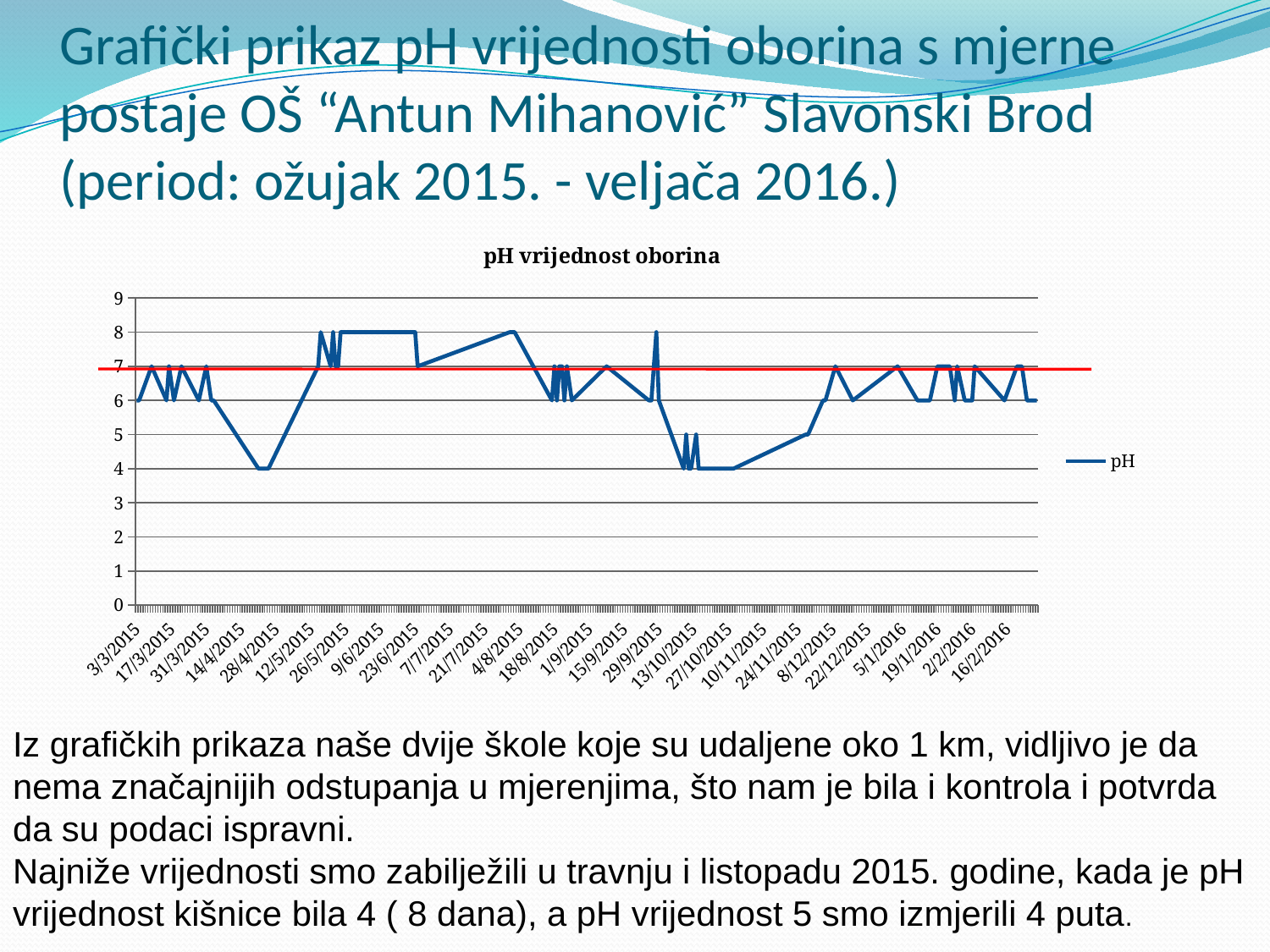
How many series does the chart legend list? 1 Does the pH value rise or fall between 14/4/2015 and 28/4/2015? fall What is the pH value on 9/6/2015? 8 What is the lowest pH value reached on the chart? 4 Is the pH value on 27/10/2015 greater or less than 5? less Is the pH value on 4/8/2015 greater or less than 7? greater What is the pH value on 27/10/2015? 4 What is the name of the series shown in the legend? pH What is the highest pH value reached on the chart? 8 What kind of chart is shown on the slide? line chart What is the title of the chart? pH vrijednost oborina